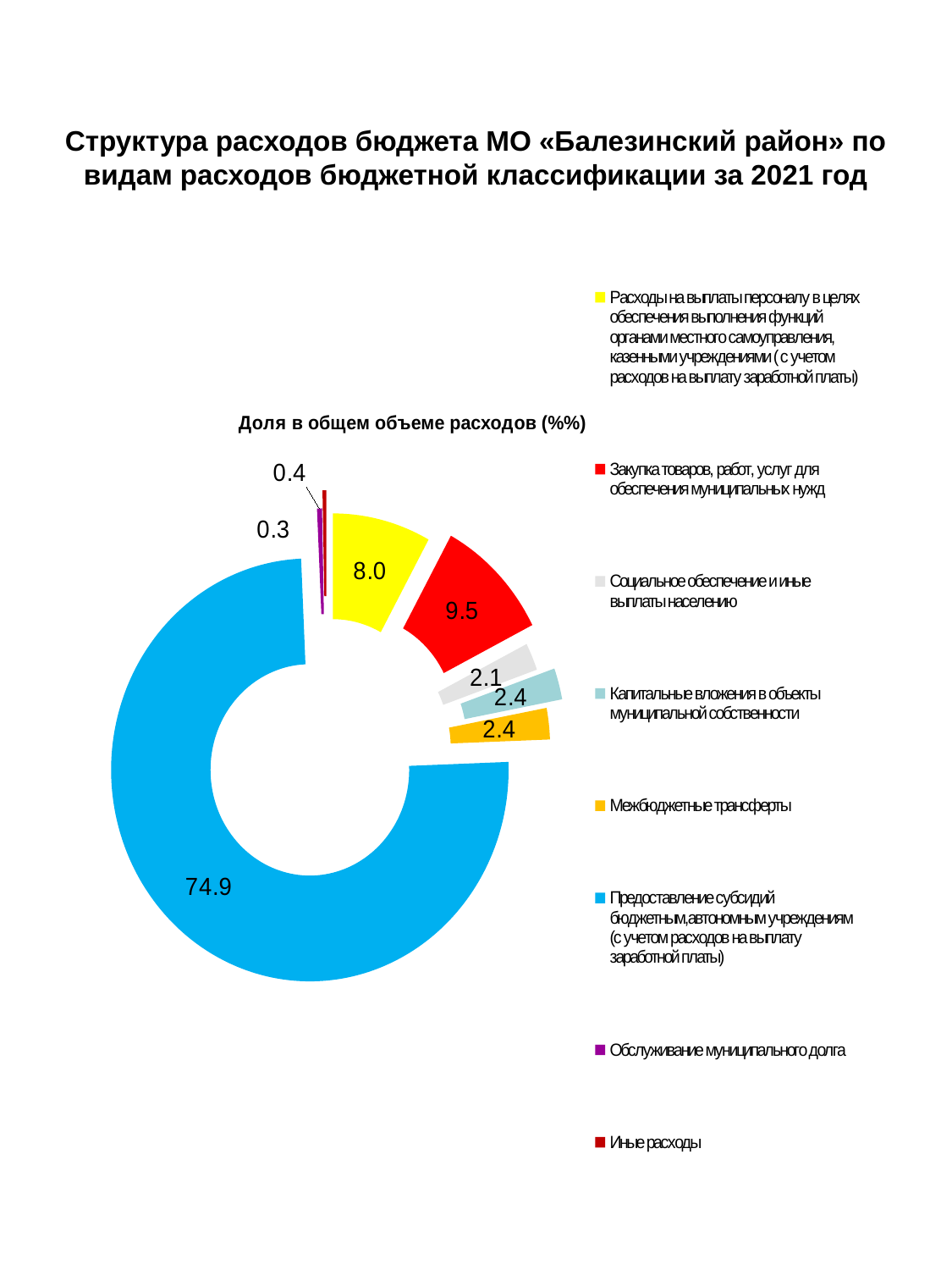
What share is shown for «Закупка товаров, работ, услуг для обеспечения муниципальных нужд»? 9.5 What share is shown for «Расходы на выплаты персоналу...» (the yellow slice)? 8.0 What is the difference between the shares for «Закупка товаров, работ, услуг» and «Расходы на выплаты персоналу»? 1.5 What share is shown for «Социальное обеспечение и иные выплаты населению»? 2.1 What kind of chart is shown on the slide? Doughnut (pie) chart What share is shown for «Межбюджетные трансферты»? 2.4 What is the difference between the shares for «Предоставление субсидий» and «Закупка товаров, работ, услуг»? 65.4 Which is larger: the share for «Закупка товаров, работ, услуг» or for «Расходы на выплаты персоналу»? Закупка товаров, работ, услуг How many categories does the legend list? 8 What share is shown for «Предоставление субсидий бюджетным, автономным учреждениям»? 74.9 Which category has the largest share of expenditures? Предоставление субсидий бюджетным, автономным учреждениям What is the chart's title? Доля в общем объеме расходов (%%)